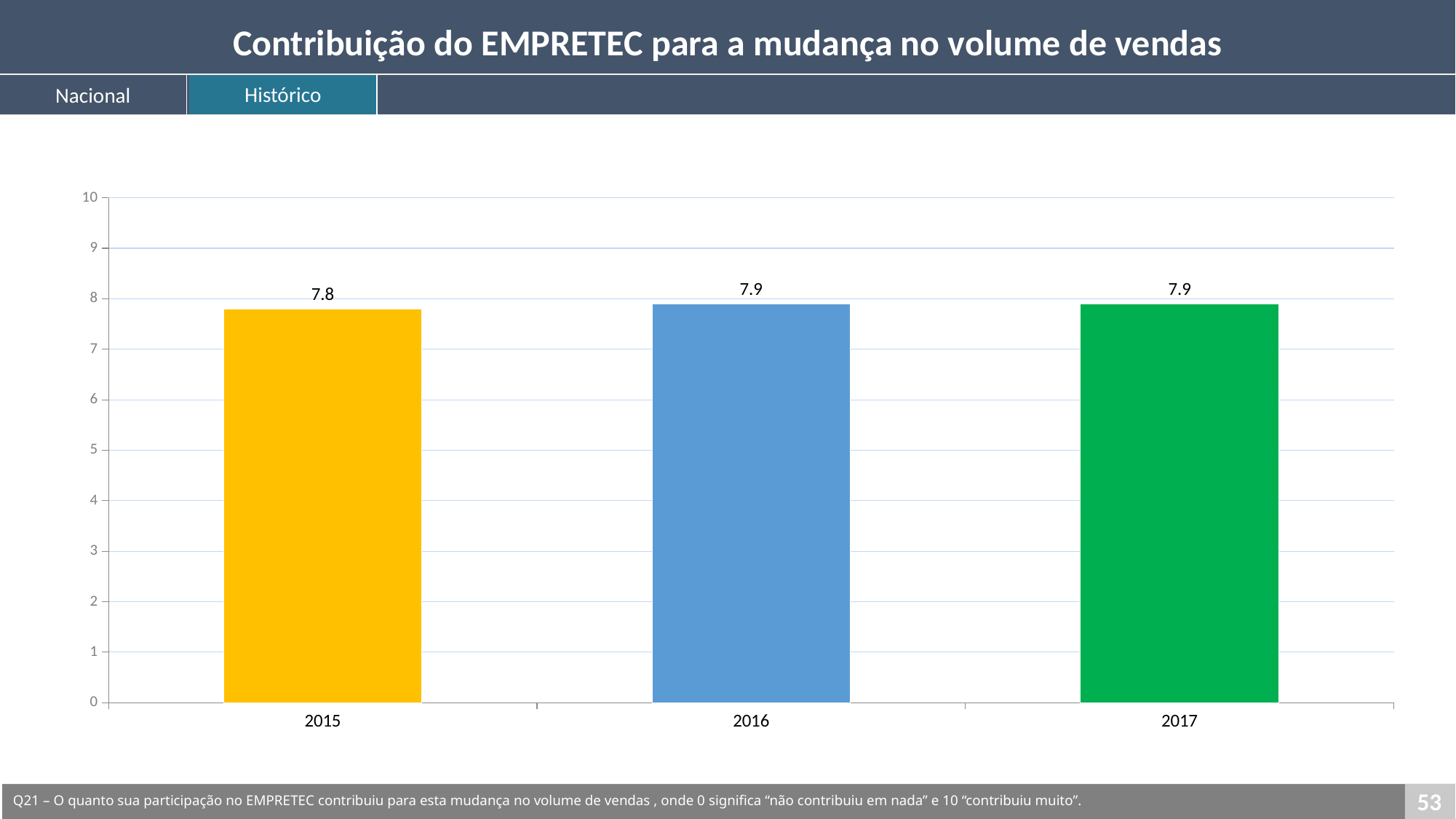
What kind of chart is shown on the slide? bar chart Does the value rise or fall from 2015 to 2016? rise How many years are shown on the x axis? 3 Which is larger, the value for 2015 or the value for 2016? 2016 Which year has the lowest value? 2015 What is the value for 2017? 7.9 What is the title of the slide? Contribuição do EMPRETEC para a mudança no volume de vendas What is the difference between the values for 2016 and 2015? 0.1 What is the value for 2015? 7.8 What colour is the bar for 2017? green Is the value for 2015 greater or less than 5? greater What is the value for 2016? 7.9